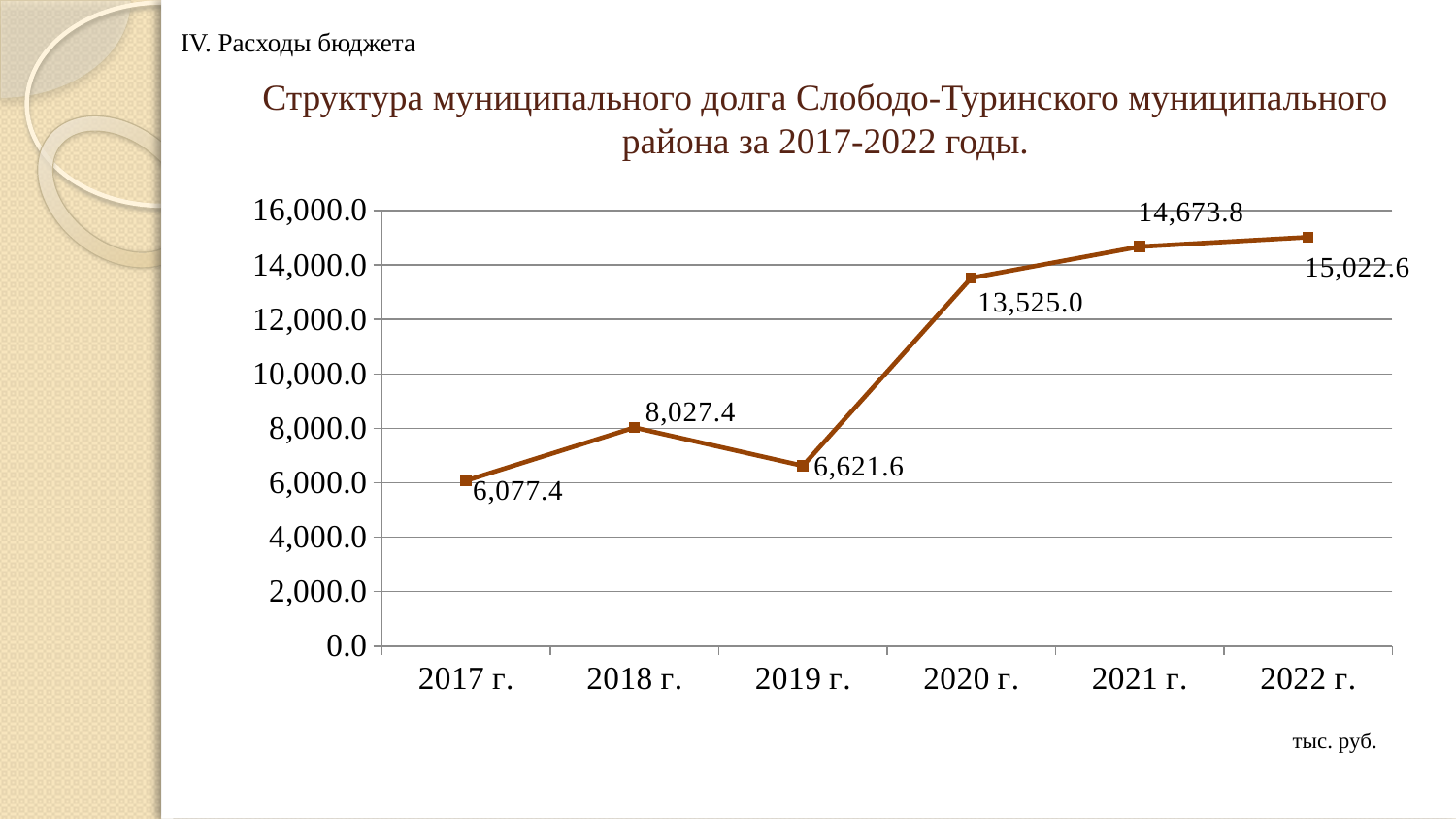
Which is larger, the value for 2018 г. or the value for 2019 г.? 2018 г. What is the difference between the values for 2022 г. and 2021 г.? 348.8 Which year has the lowest value? 2017 г. What kind of chart is shown on the slide? line chart What is the value for 2017 г.? 6,077.4 Which year has the highest value? 2022 г. How many years are plotted on the chart? 6 What is the difference between the values for 2020 г. and 2019 г.? 6,903.4 What is the value for 2020 г.? 13,525.0 What is the value for 2022 г.? 15,022.6 Is the value for 2021 г. greater or less than 14,000.0? greater What unit is indicated below the chart? тыс. руб.